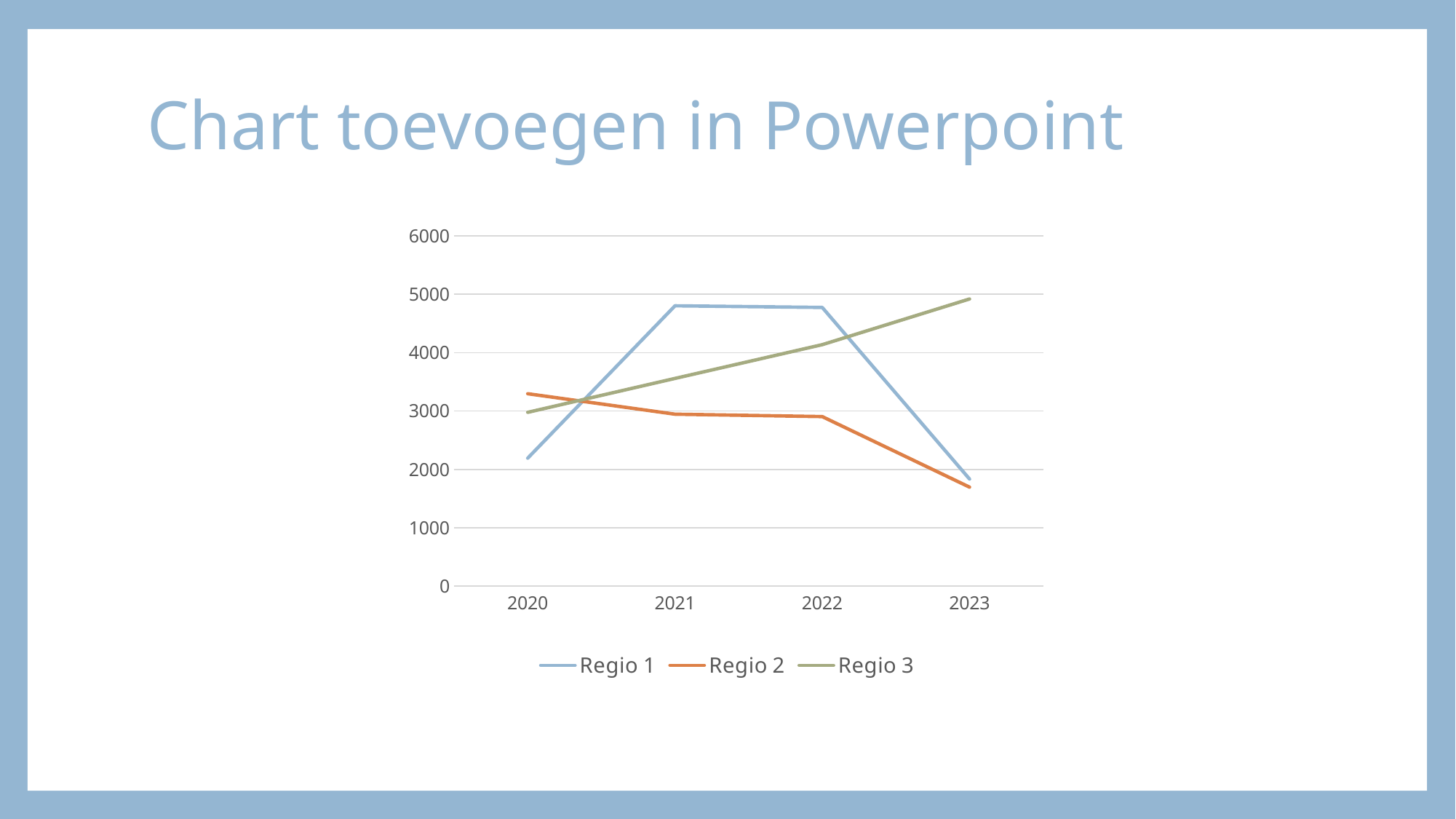
Is the value for Regio 1 in 2020 greater or less than 3000? less How many years are shown on the x axis? 4 Is the value for Regio 3 in 2023 greater or less than 4000? greater Does the value for Regio 3 rise or fall from 2020 to 2023? rise Which series is drawn in orange? Regio 2 In 2022, which is larger: Regio 1 or Regio 2? Regio 1 Is the value for Regio 1 in 2021 greater or less than 4000? greater Which series has the highest value in 2023? Regio 3 How many series does the legend list? 3 What kind of chart is shown on the slide? line chart Which series has the lowest value in 2020? Regio 1